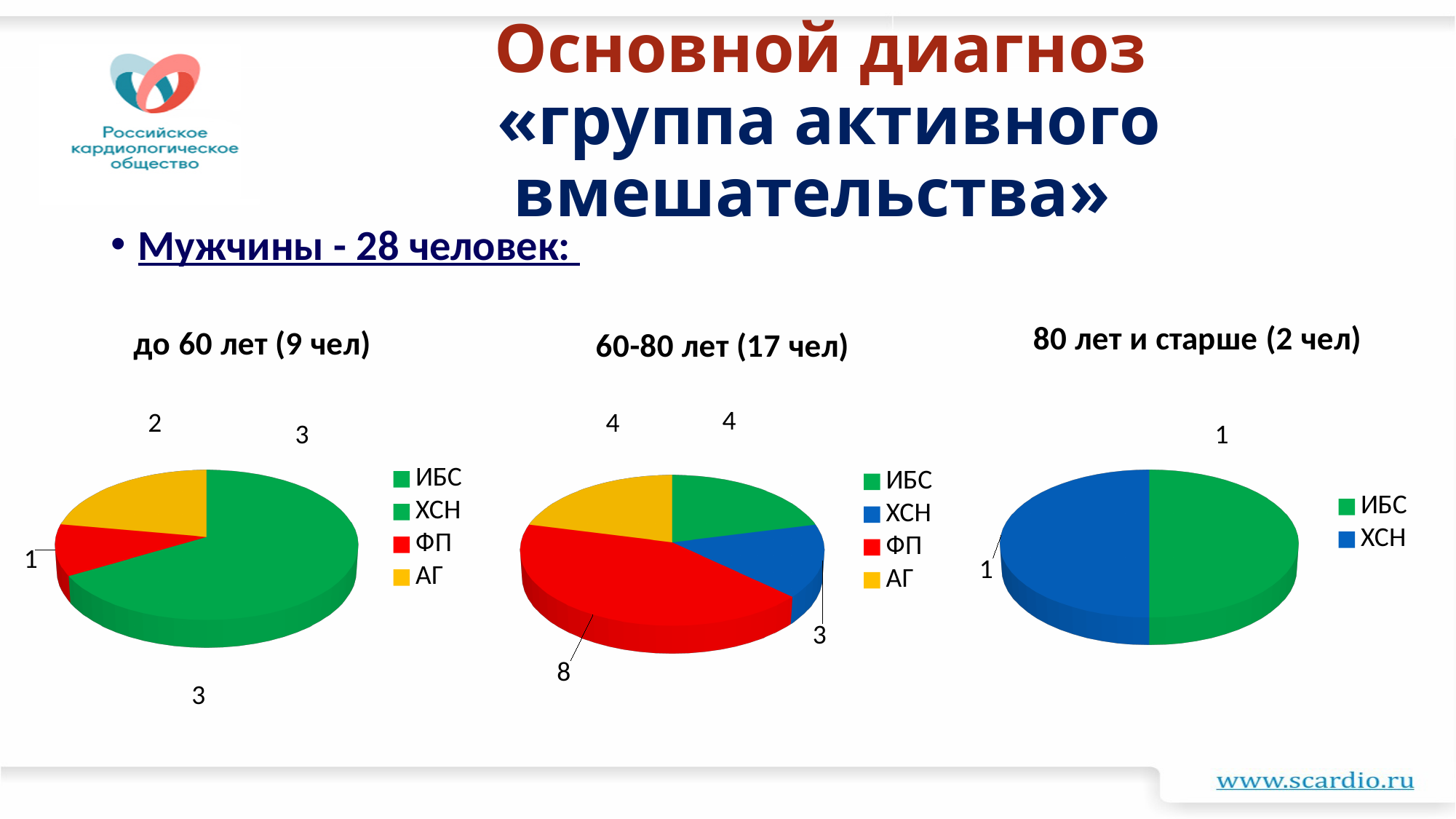
In the '60-80 лет (17 чел)' chart, what is the value for ХСН? 3 In the '60-80 лет (17 чел)' chart, which category has the largest value? ФП In the '80 лет и старше (2 чел)' chart, what is the value for ИБС? 1 In the 'до 60 лет (9 чел)' chart, what is the value for АГ? 2 How many entries does the legend of the 'до 60 лет (9 чел)' chart list? 4 In the '60-80 лет (17 чел)' chart, what is the difference between the values for ФП and ХСН? 5 What kind of chart is the 'до 60 лет (9 чел)' chart? pie chart In the 'до 60 лет (9 чел)' chart, what is the value for ФП? 1 In the '60-80 лет (17 чел)' chart, which is larger, ФП or АГ? ФП How many entries does the legend of the '80 лет и старше (2 чел)' chart list? 2 In the 'до 60 лет (9 чел)' chart, which category has the smallest value? ФП In the '60-80 лет (17 чел)' chart, what is the value for ФП? 8